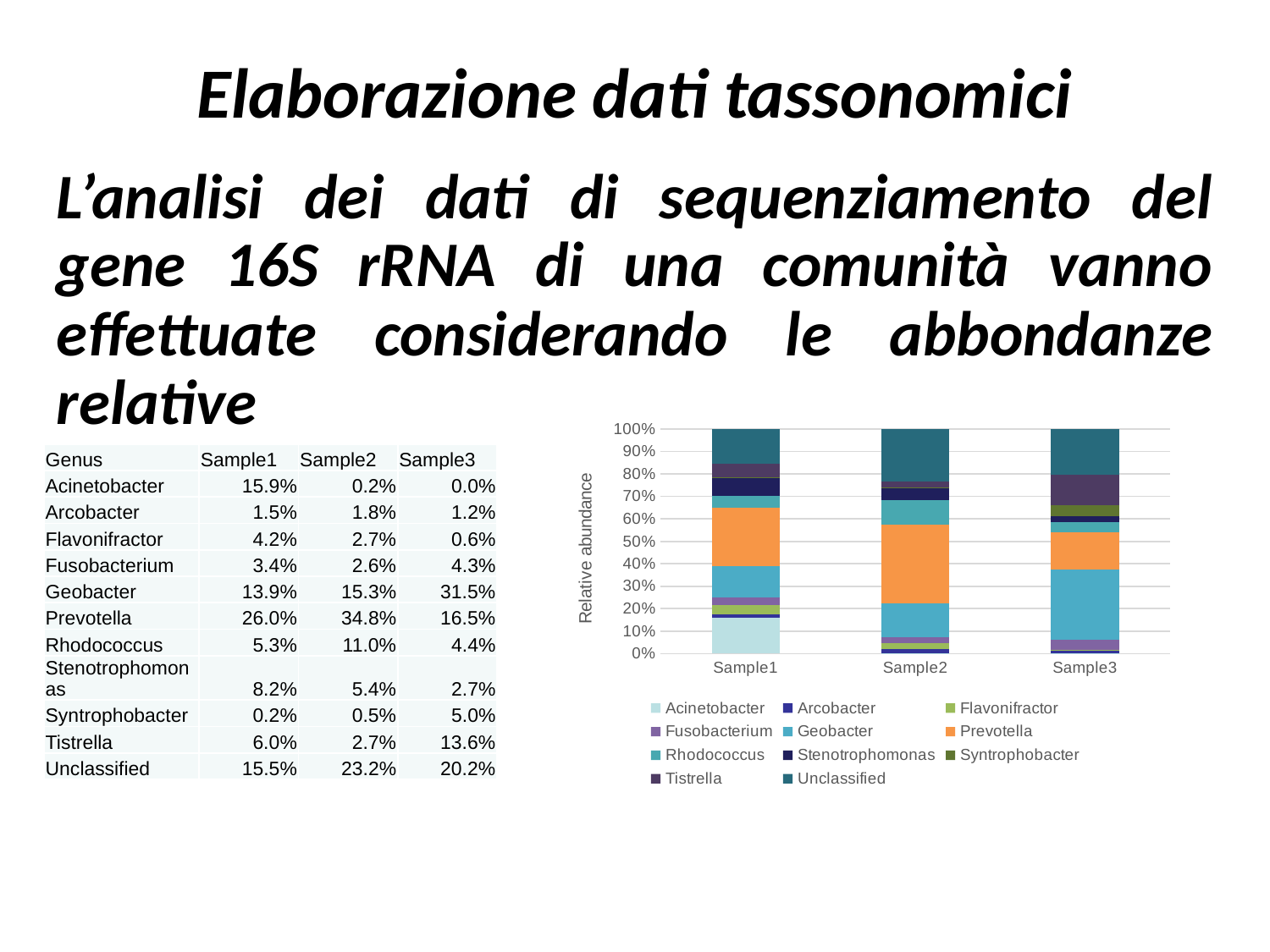
Is the Unclassified share larger in Sample2 or in Sample1? Sample2 Which sample has the lowest relative abundance of Prevotella? Sample3 How many samples (categories) are plotted on the x axis of the chart? 3 What is the relative abundance of Acinetobacter in Sample1? 15.9% What is the difference between the Prevotella relative abundance in Sample2 and in Sample1? 8.8% Is the relative abundance of Tistrella in Sample3 greater or less than 10%? greater What is the relative abundance of Geobacter in Sample3? 31.5% What is the label of the y axis of the chart? Relative abundance What is the relative abundance of Prevotella in Sample2? 34.8% Which sample has the highest relative abundance of Geobacter? Sample3 How many series does the chart legend list? 11 What kind of chart is shown on the slide? stacked bar chart